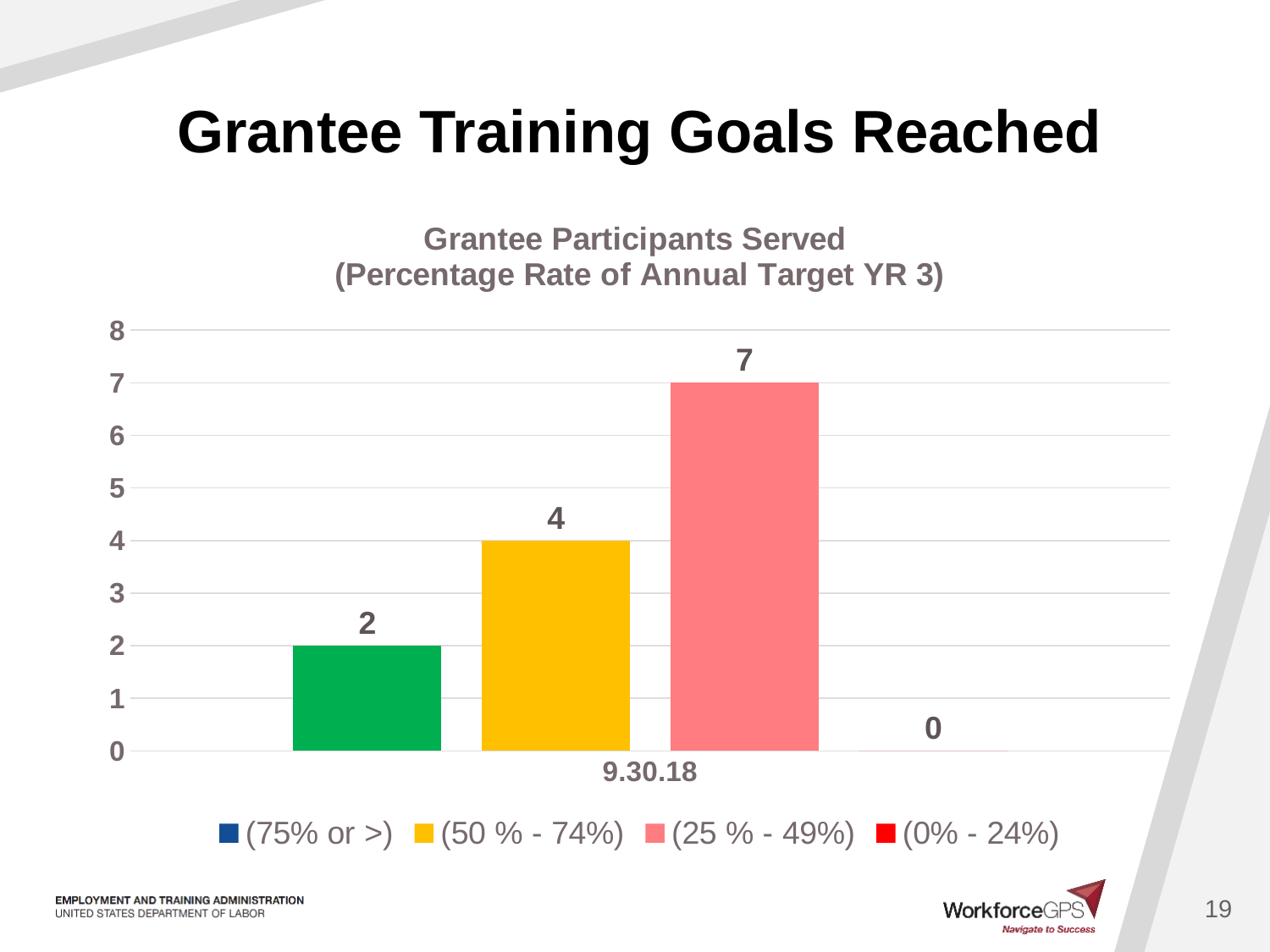
What is the difference between the (25 % - 49%) value and the (50 % - 74%) value? 3 What is the value for the (0% - 24%) series on 9.30.18? 0 What is the value for the (25 % - 49%) series on 9.30.18? 7 Which series has the highest value on 9.30.18? (25 % - 49%) Which series has the lowest value on 9.30.18? (0% - 24%) What is the value for the (75% or >) series on 9.30.18? 2 What is the value for the (50 % - 74%) series on 9.30.18? 4 What is the title of the chart? Grantee Participants Served (Percentage Rate of Annual Target YR 3) How many series does the legend list? 4 What kind of chart is shown on the slide? bar chart Which is larger, the (50 % - 74%) value or the (75% or >) value? (50 % - 74%) Is the value for the (25 % - 49%) series greater or less than 5? greater